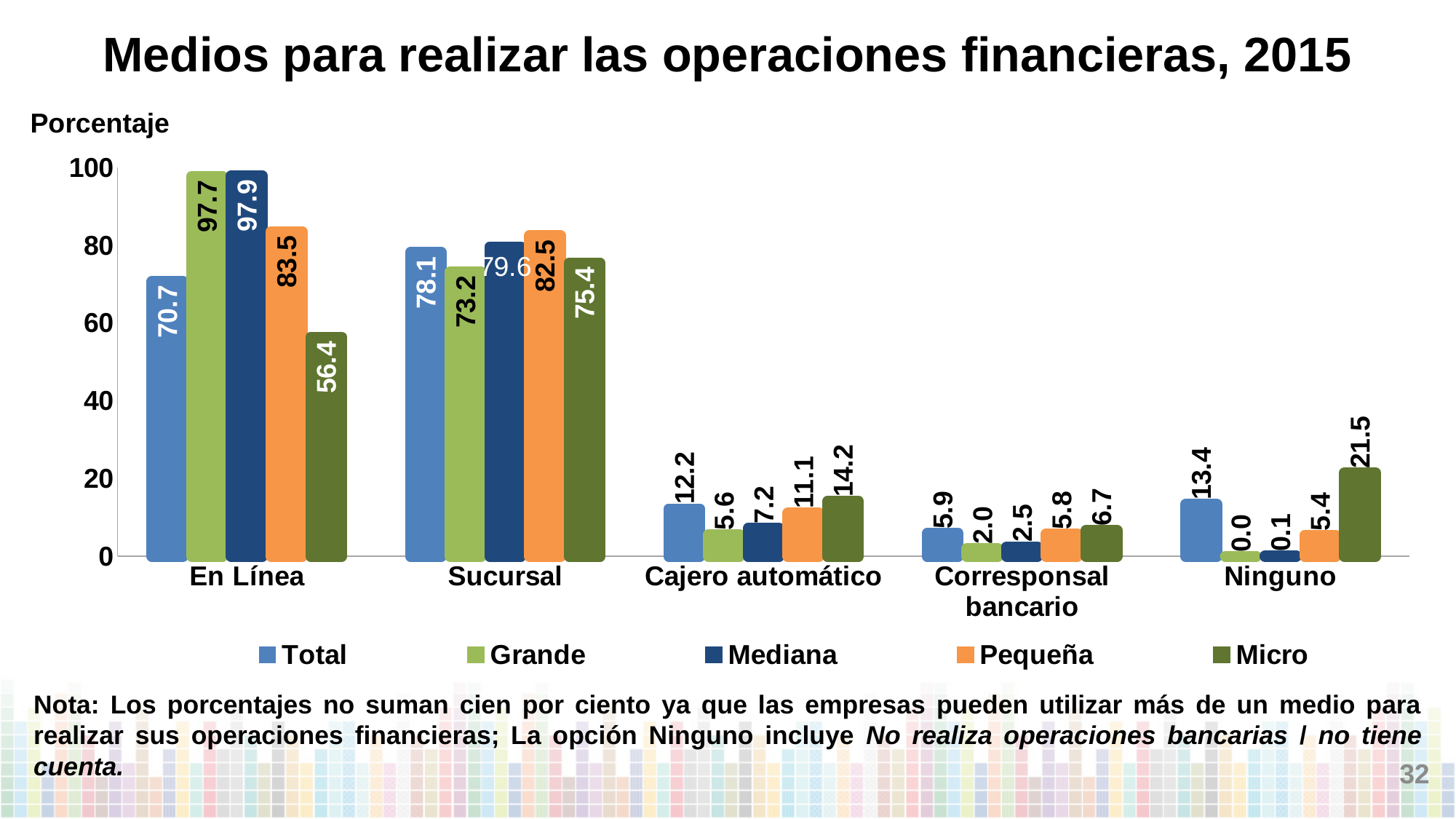
How many series does the legend list? 5 Which series has the highest value in the En Línea category? Mediana What is the value for Micro in the Ninguno category? 21.5 What is the value for Total in the En Línea category? 70.7 What is the value for Grande in the Corresponsal bancario category? 2.0 Which series has the lowest value in the Ninguno category? Grande What kind of chart is shown on the slide? bar chart What is the title of the chart? Medios para realizar las operaciones financieras, 2015 How many categories are shown on the x axis? 5 Is the value for Micro in the En Línea category greater or less than 60? less What is the difference between the Grande and Micro values in the En Línea category? 41.3 Which is larger in the Sucursal category: the value for Pequeña or the value for Grande? Pequeña